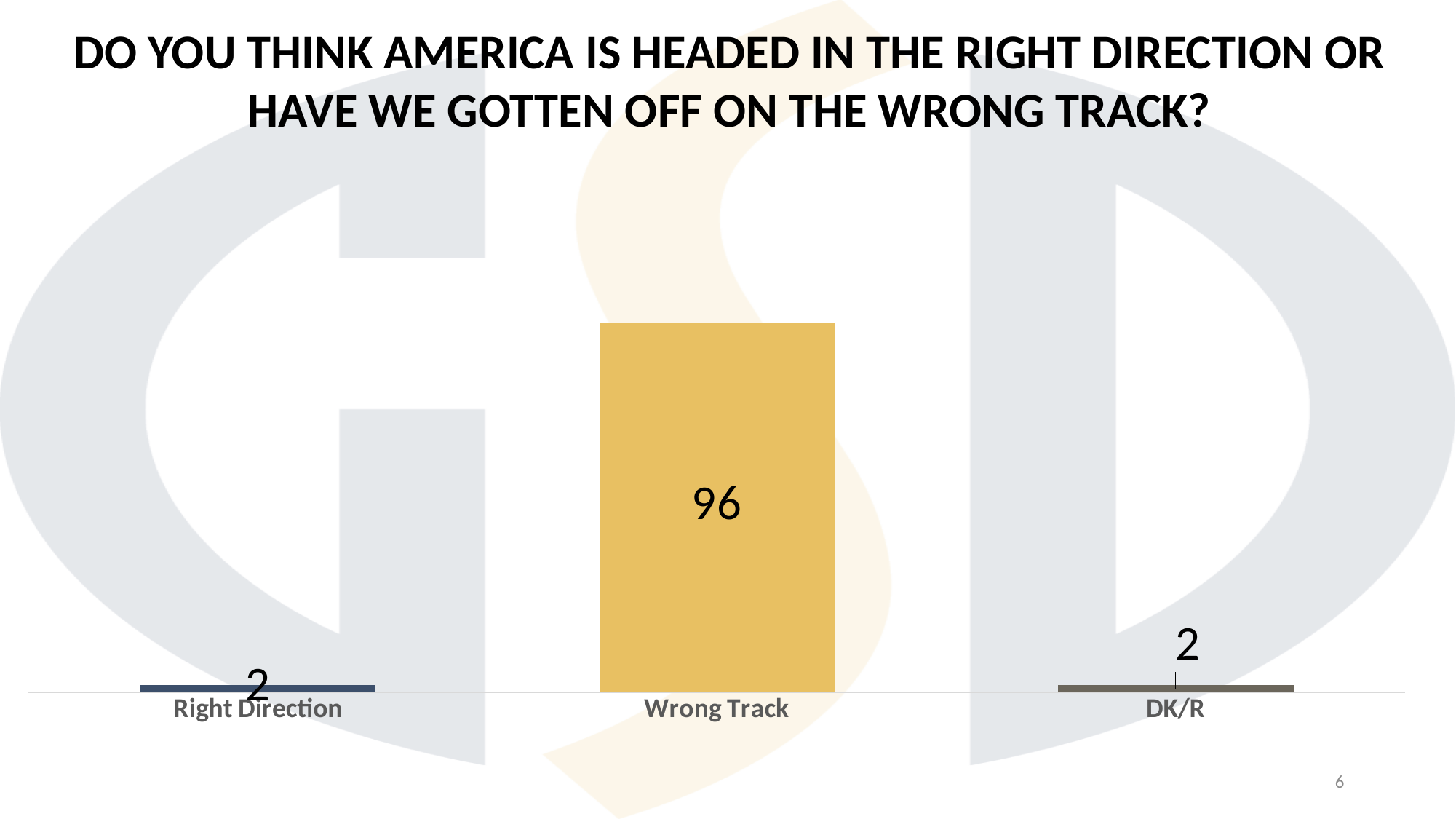
What is the value for DK/R? 2 What colour is the Wrong Track bar? Gold What kind of chart is shown on the slide? bar chart What is the total of the values for Right Direction, Wrong Track and DK/R? 100 What is the value for Right Direction? 2 How many categories are shown on the chart? 3 What is the value for Wrong Track? 96 What is the difference between the values for Wrong Track and Right Direction? 94 Which category has the highest value? Wrong Track What is the title of the chart? Do you think America is headed in the right direction or have we gotten off on the wrong track? Which is larger, the value for Wrong Track or the value for DK/R? Wrong Track